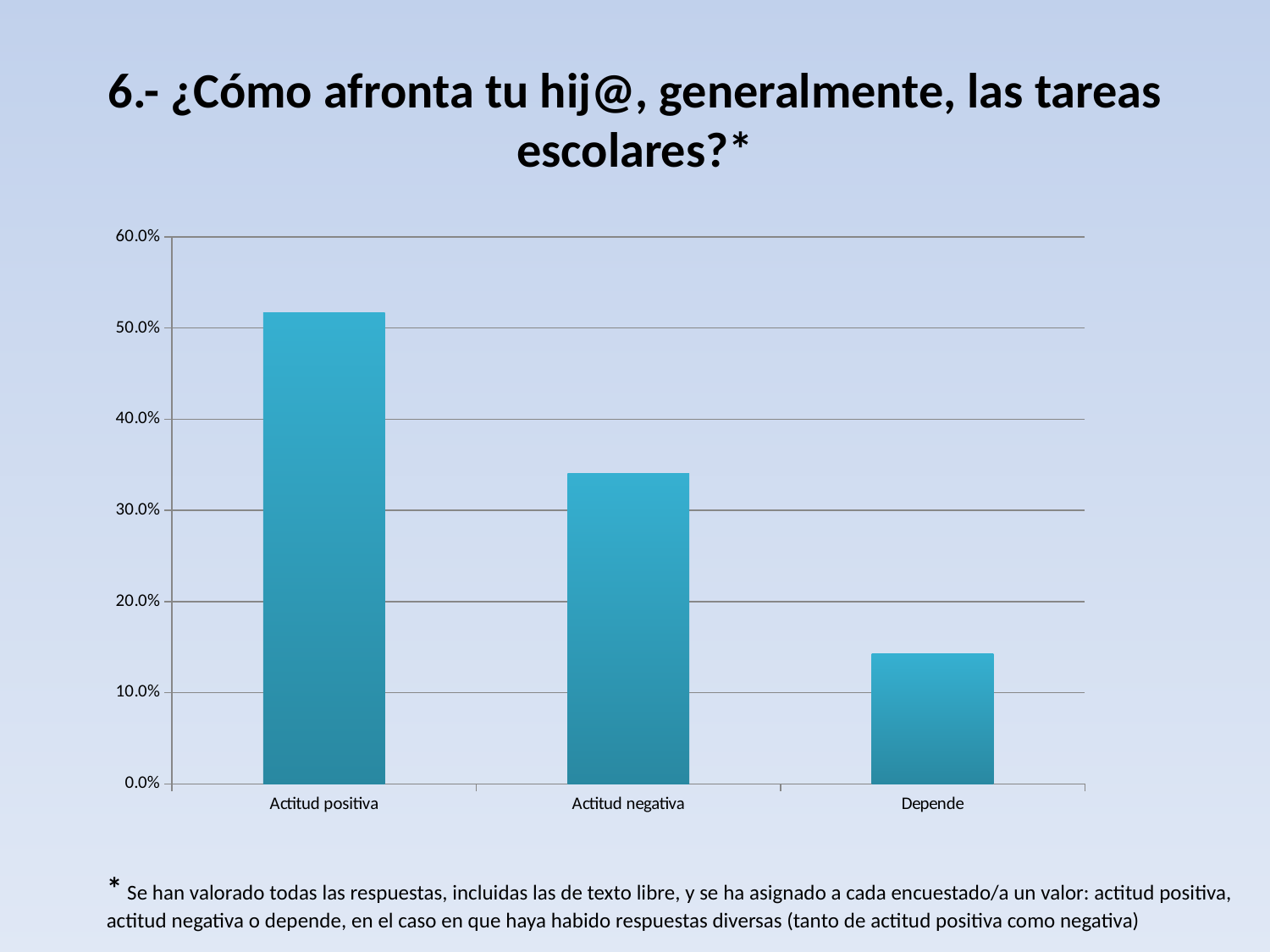
Is the value for Actitud positiva greater or less than 40.0%? greater How many categories are shown on the x axis of the chart? 3 Which is larger, the value for Actitud positiva or the value for Actitud negativa? Actitud positiva Is the value for Actitud negativa greater or less than 40.0%? less What is the highest value shown on the y axis of the chart? 60.0% Which category has the lowest value in the chart? Depende Which is larger, the value for Actitud negativa or the value for Depende? Actitud negativa Which category has the highest value in the chart? Actitud positiva What kind of chart is shown on the slide? bar chart Is the value for Depende greater or less than 20.0%? less Do the values rise or fall from left to right across the categories? fall